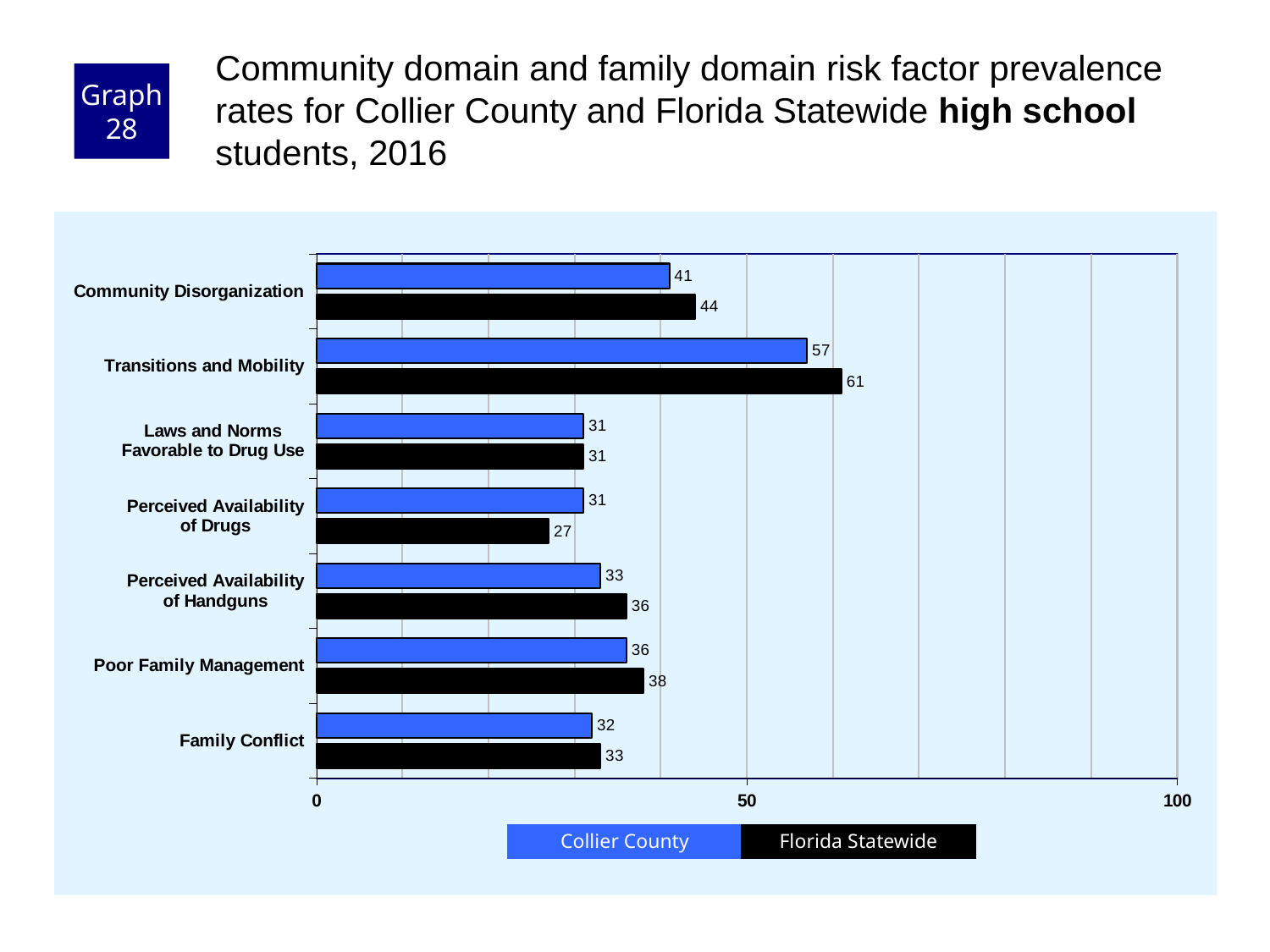
Which is larger for Perceived Availability of Handguns: the Collier County value or the Florida Statewide value? Florida Statewide What is the Florida Statewide value for Poor Family Management? 38 What is the Collier County value for Transitions and Mobility? 57 How many series does the legend list? 2 Which risk factor has the highest Florida Statewide value? Transitions and Mobility Which risk factor has the lowest Collier County value? Laws and Norms Favorable to Drug Use and Perceived Availability of Drugs (both 31) What kind of chart is shown on the slide? Bar chart What is the Florida Statewide value for Perceived Availability of Drugs? 27 Which colour represents Florida Statewide in the chart? Black Is the Florida Statewide value for Transitions and Mobility greater or less than 50? greater How many risk factor categories are shown on the chart? 7 What is the difference between the Florida Statewide and Collier County values for Community Disorganization? 3